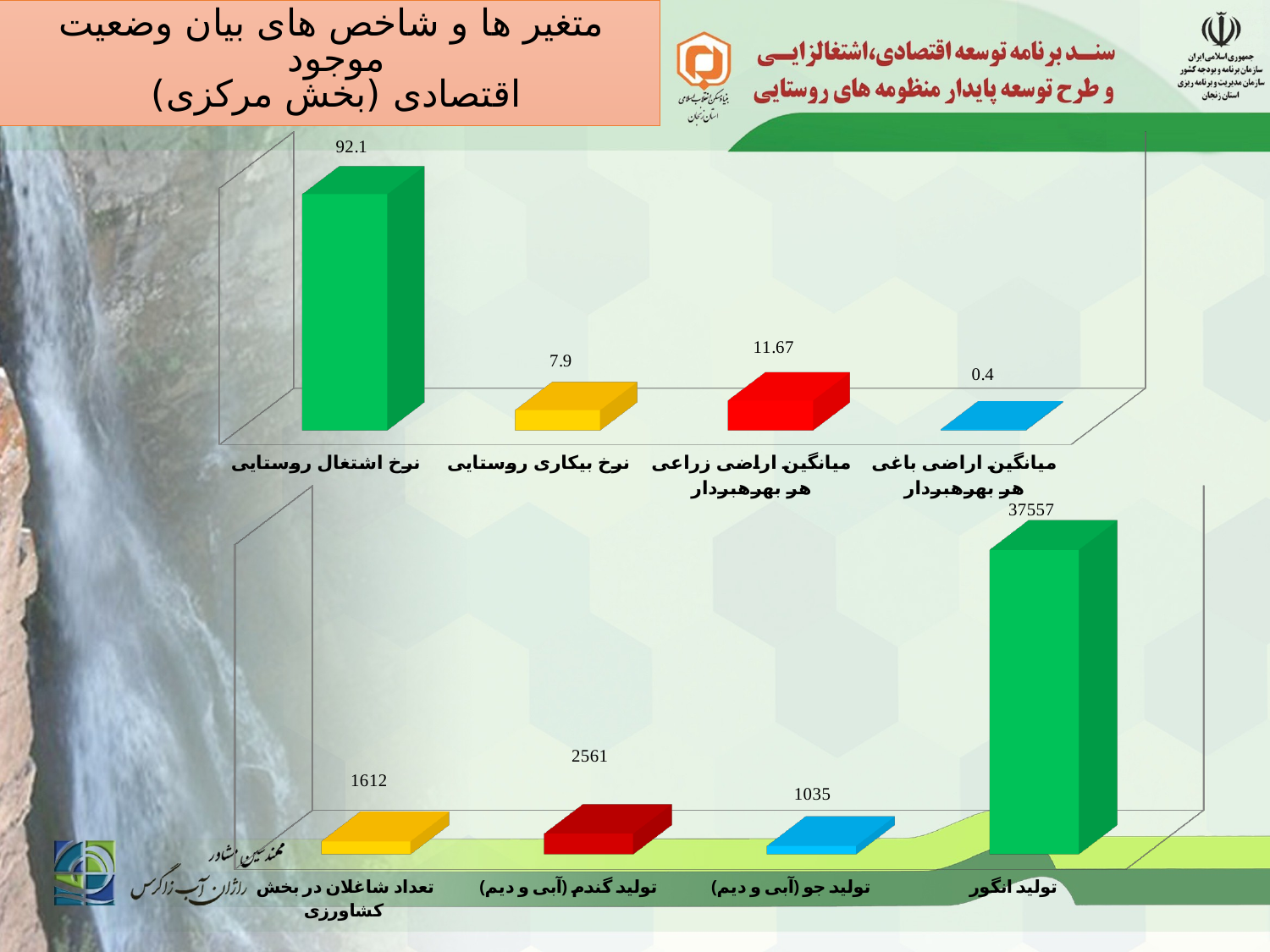
In the top chart, which is larger: نرخ بیکاری روستایی or میانگین اراضی زراعی هر بهره‌بردار? میانگین اراضی زراعی هر بهره‌بردار In the bottom chart, what is the value for تولید انگور? 37557 In the bottom chart, what is the difference between تولید گندم (آبی و دیم) and تعداد شاغلان در بخش کشاورزی? 949 In the top chart, which category has the lowest value? میانگین اراضی باغی هر بهره‌بردار In the top chart, what is the value for میانگین اراضی زراعی هر بهره‌بردار? 11.67 In the bottom chart, what is the value for تولید جو (آبی و دیم)? 1035 In the top chart, what is the difference between نرخ اشتغال روستایی and نرخ بیکاری روستایی? 84.2 In the top chart, what is the value for نرخ اشتغال روستایی? 92.1 In the bottom chart, which category has the highest value? تولید انگور What type of chart is the bottom chart? Bar chart In the bottom chart, what colour is the bar for تولید انگور? Green How many categories are shown in the top chart? 4